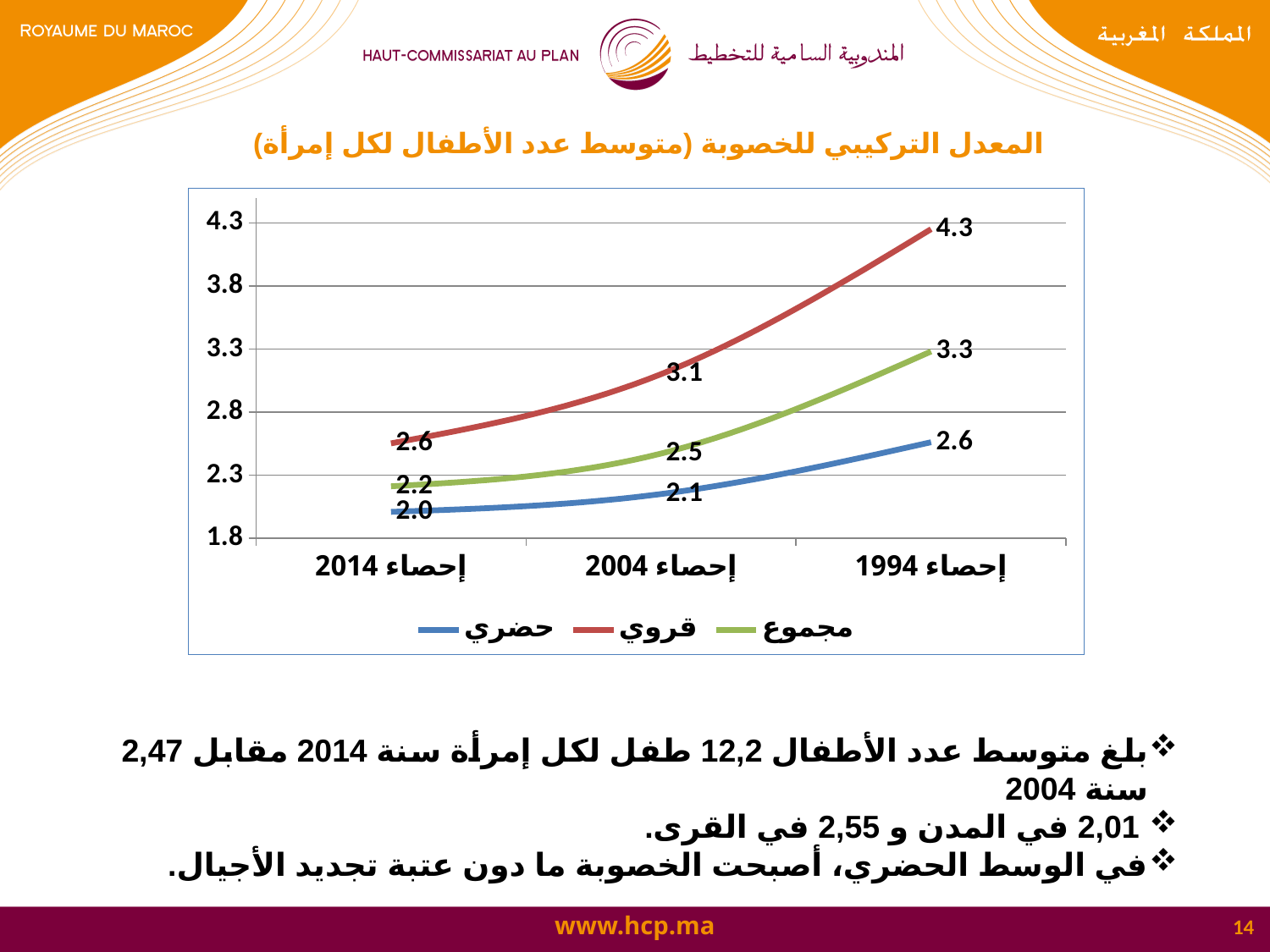
What is the value for حضري (urban) in إحصاء 2014? 2.0 Which series has the highest value in إحصاء 1994? قروي What type of chart is shown on the slide? line chart What is the value for مجموع (total) in إحصاء 2004? 2.5 How many series does the legend list? 3 What is the value for قروي (rural) in إحصاء 1994? 4.3 What is the difference between the قروي (rural) values in إحصاء 1994 and إحصاء 2014? 1.7 How many census years are shown on the x axis? 3 Which series has the lowest value in إحصاء 2014? حضري What colour is the line for the حضري (urban) series? blue Which is larger: the مجموع (total) value in إحصاء 1994 or the قروي (rural) value in إحصاء 2004? مجموع in إحصاء 1994 Do the values of the قروي (rural) series rise or fall moving from إحصاء 1994 to إحصاء 2014? fall